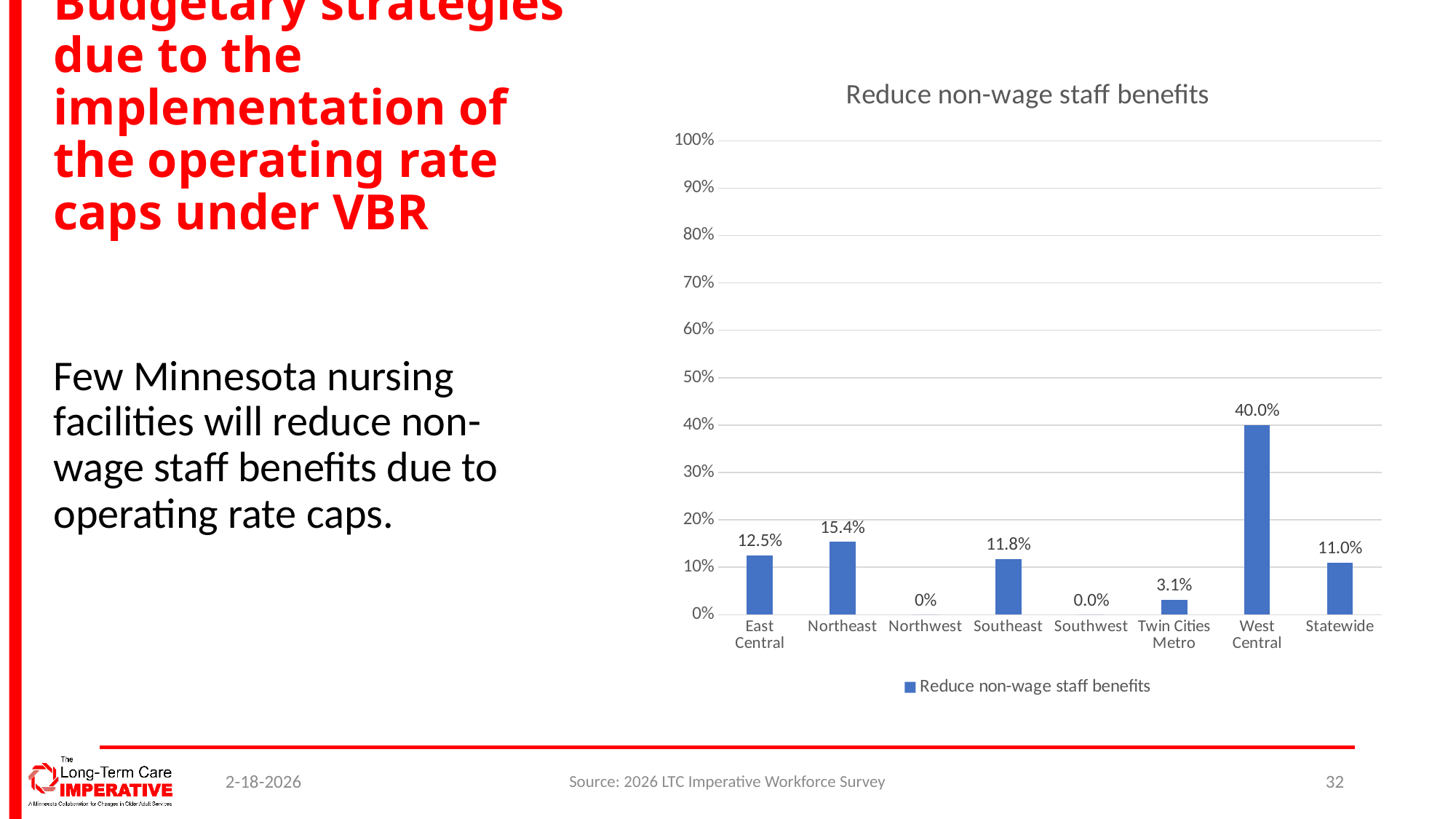
How many categories are shown on the x axis? 8 What is the title of the chart? Reduce non-wage staff benefits Is the value for West Central greater or less than 30%? greater What is the value for West Central? 40.0% What is the value for Twin Cities Metro? 3.1% What is the value for Northeast? 15.4% What is the Statewide value? 11.0% Which is larger, the value for East Central or the value for Southeast? East Central What kind of chart is shown? bar chart How many series does the legend list? 1 What is the difference between the West Central and Statewide values? 29.0% Which region has the highest value? West Central